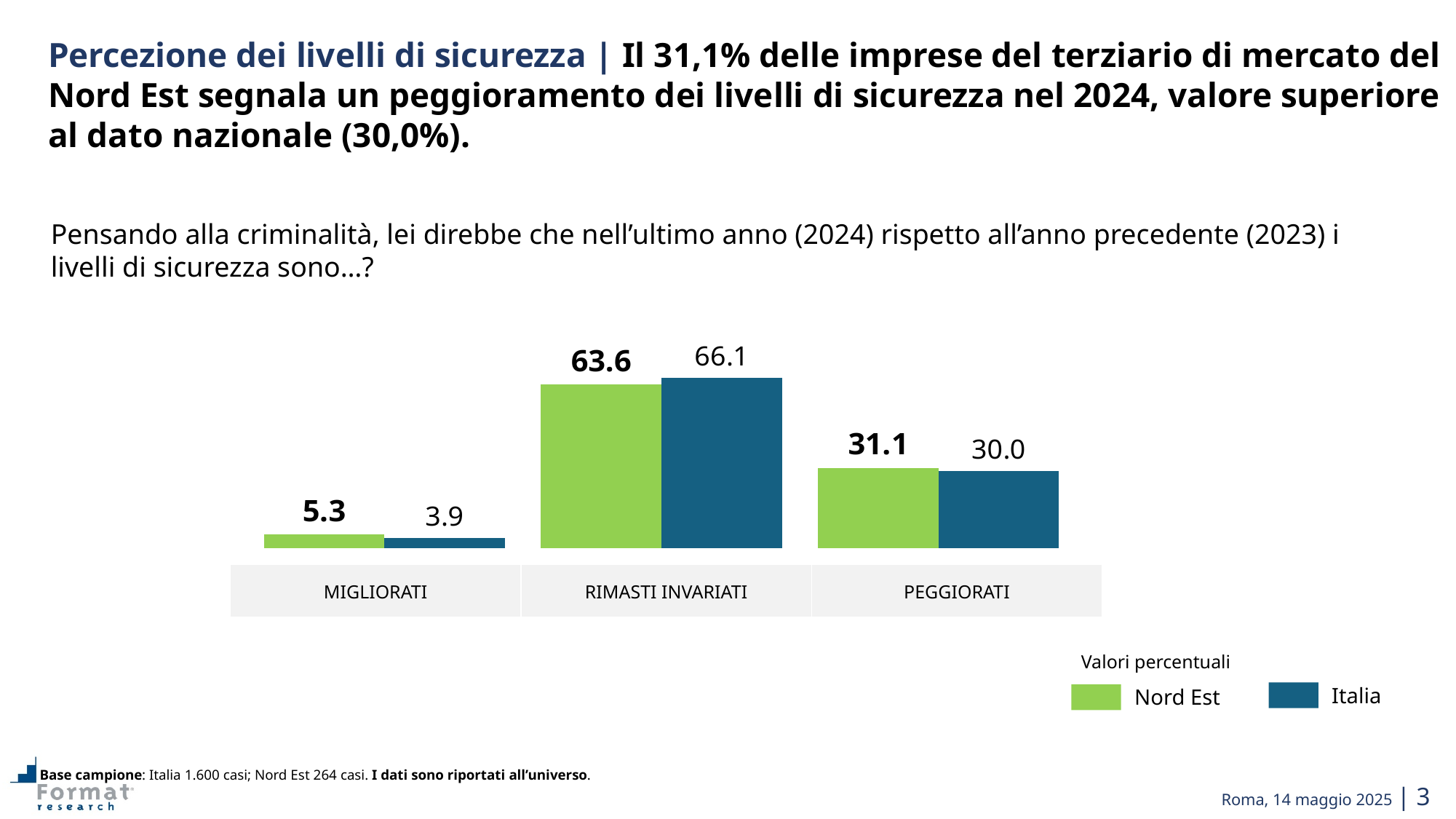
What is the value for Nord Est in the RIMASTI INVARIATI category? 63.6 Which category has the highest value for Italia? RIMASTI INVARIATI How many series does the legend list? 2 Which category has the lowest value for Nord Est? MIGLIORATI Which colour represents the Nord Est series in the chart? Green What is the value for Italia in the PEGGIORATI category? 30.0 How many categories are shown on the x axis of the chart? 3 What is the value for Italia in the MIGLIORATI category? 3.9 In the PEGGIORATI category, which series has the larger value, Nord Est or Italia? Nord Est What is the difference between the Italia and Nord Est values in the RIMASTI INVARIATI category? 2.5 What is the value for Nord Est in the MIGLIORATI category? 5.3 What kind of chart is shown on the slide? Bar chart